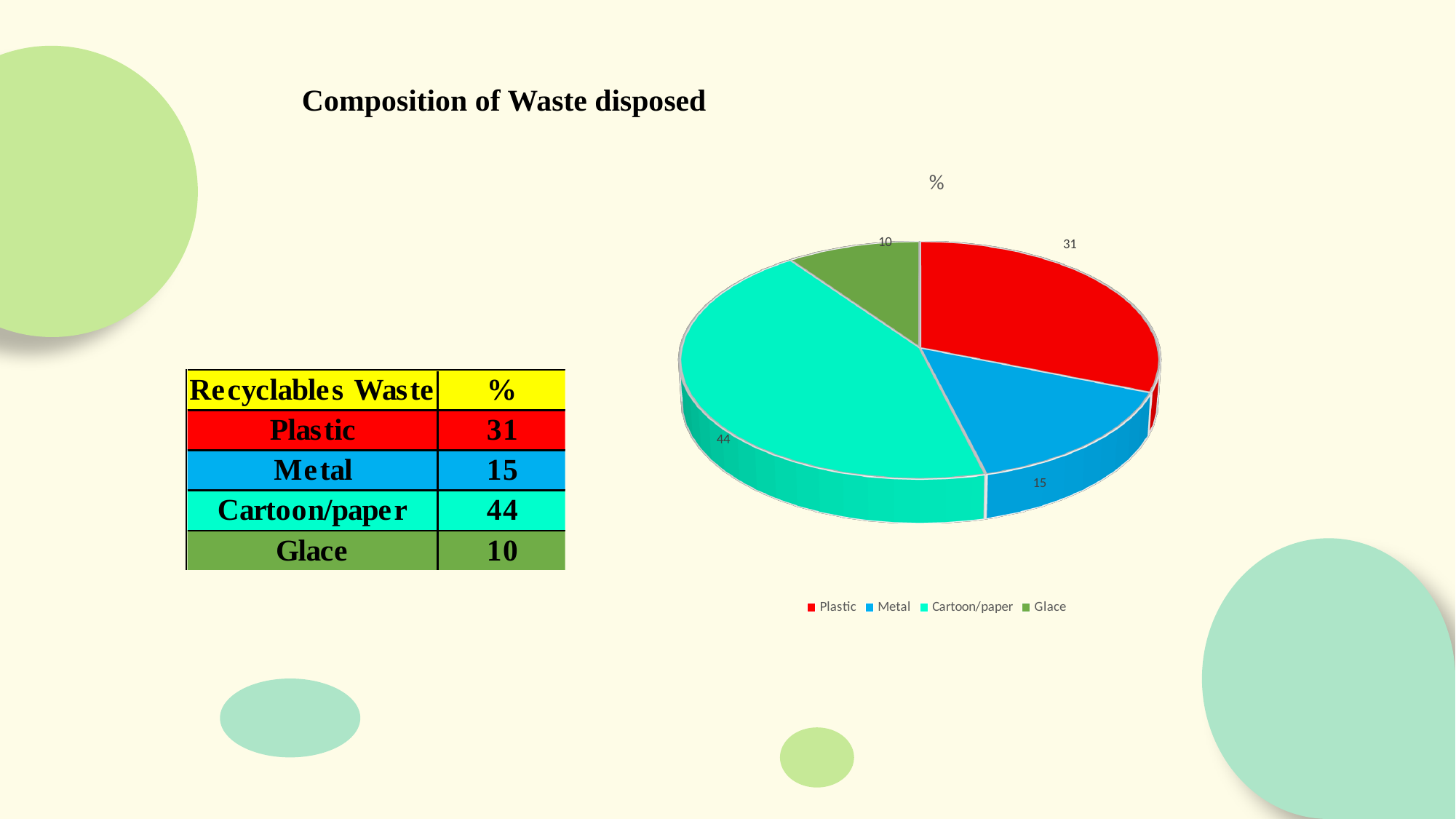
How many categories does the pie chart show? 4 What is the value for Plastic in the pie chart? 31 What is the title of the pie chart? % Which category has the smallest slice in the pie chart? Glace What is the value for Metal in the pie chart? 15 Which category has the largest slice in the pie chart? Cartoon/paper What is the difference between the values for Cartoon/paper and Plastic? 13 What colour is the Metal slice in the pie chart? blue What is the value for Cartoon/paper in the pie chart? 44 Which is larger, the value for Plastic or the value for Metal? Plastic What is the value for Glace in the pie chart? 10 What kind of chart is shown on the slide? pie chart